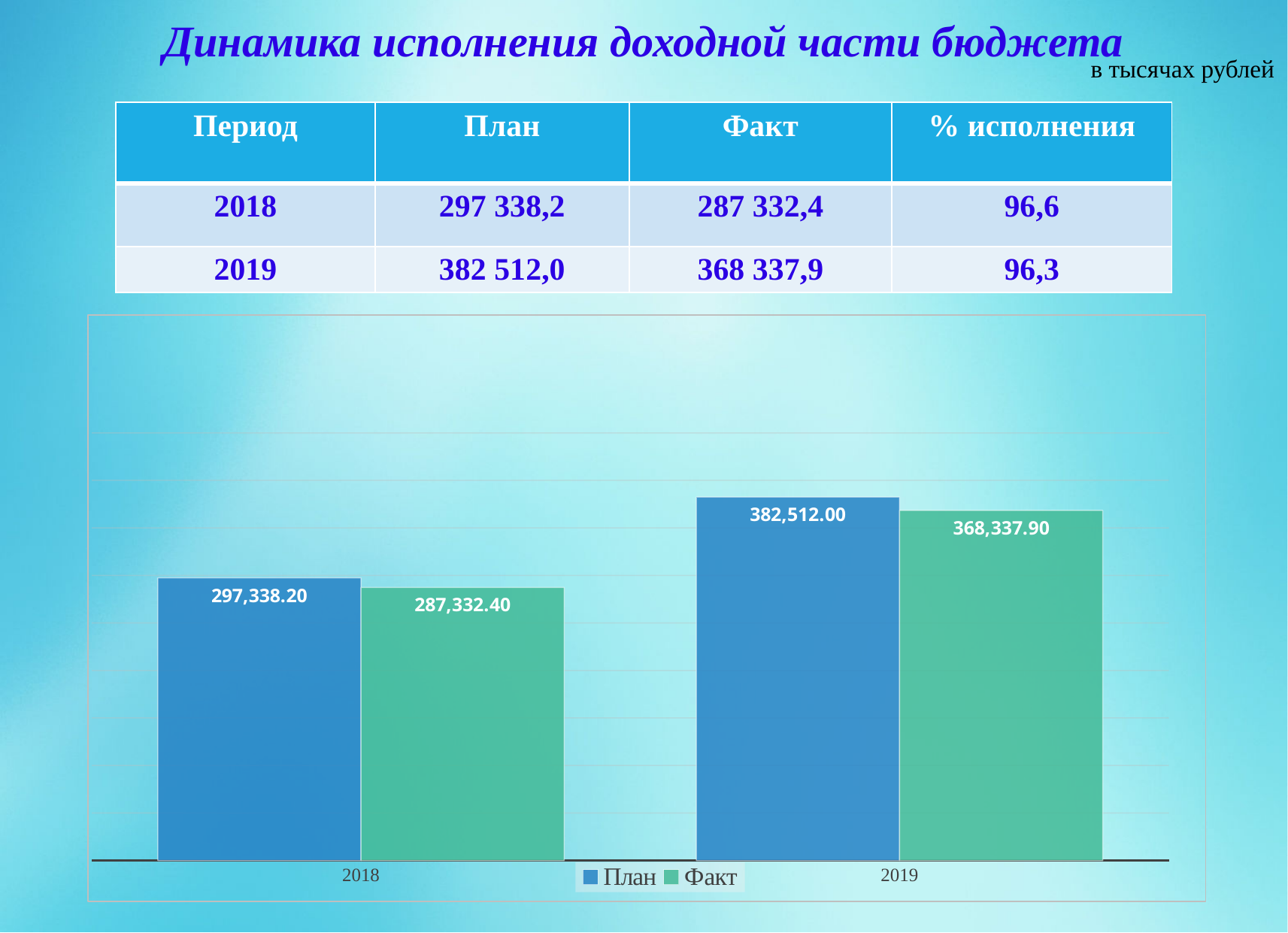
What type of chart is shown on the slide? bar chart What is the difference between the План and Факт values for 2018 in the chart? 10,005.80 In the chart, is the Факт value for 2019 larger or smaller than the План value for 2018? larger What is the value of the Факт bar for 2019 in the chart? 368,337.90 What is the difference between the План and Факт values for 2019 in the chart? 14,174.10 Which bar in the chart has the highest value? План 2019 What is the value of the План bar for 2019 in the chart? 382,512.00 Which bar in the chart has the lowest value? Факт 2018 How many series does the chart legend list? 2 Do the Факт values rise or fall from 2018 to 2019 in the chart? rise What is the value of the Факт bar for 2018 in the chart? 287,332.40 What is the value of the План bar for 2018 in the chart? 297,338.20